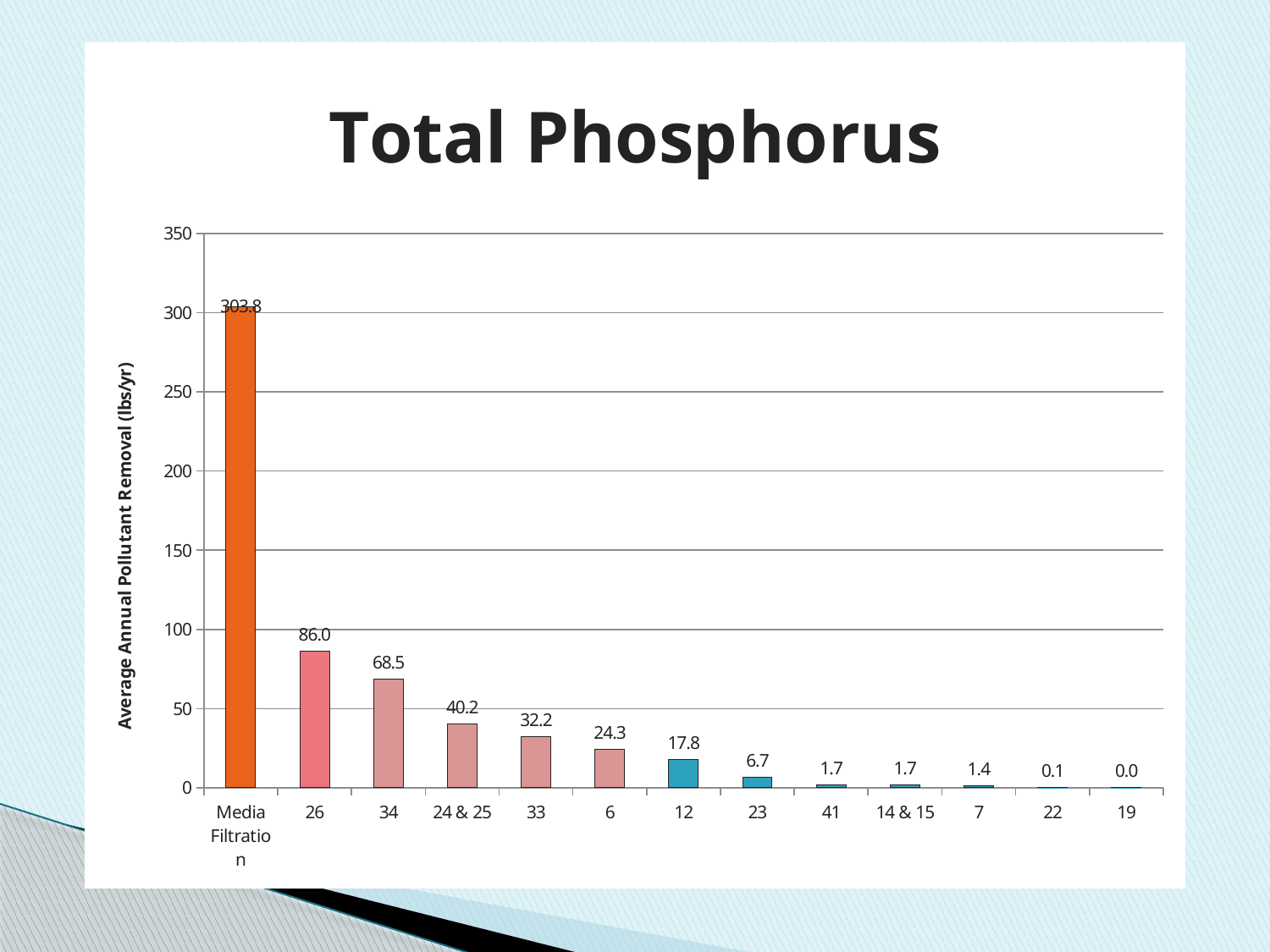
Is the value for category 26 greater or less than 100? less What is the difference between the values for category 26 and category 34? 17.5 What is the value for category 34? 68.5 Which category has the lowest value? 19 Which is larger, the value for category 33 or the value for category 6? 33 What is the title of the chart? Total Phosphorus What is the value for category 24 & 25? 40.2 What kind of chart is shown? bar chart What is the value for Media Filtration? 303.8 How many categories are shown on the x axis? 13 What is the value for category 12? 17.8 Which category has the highest value? Media Filtration